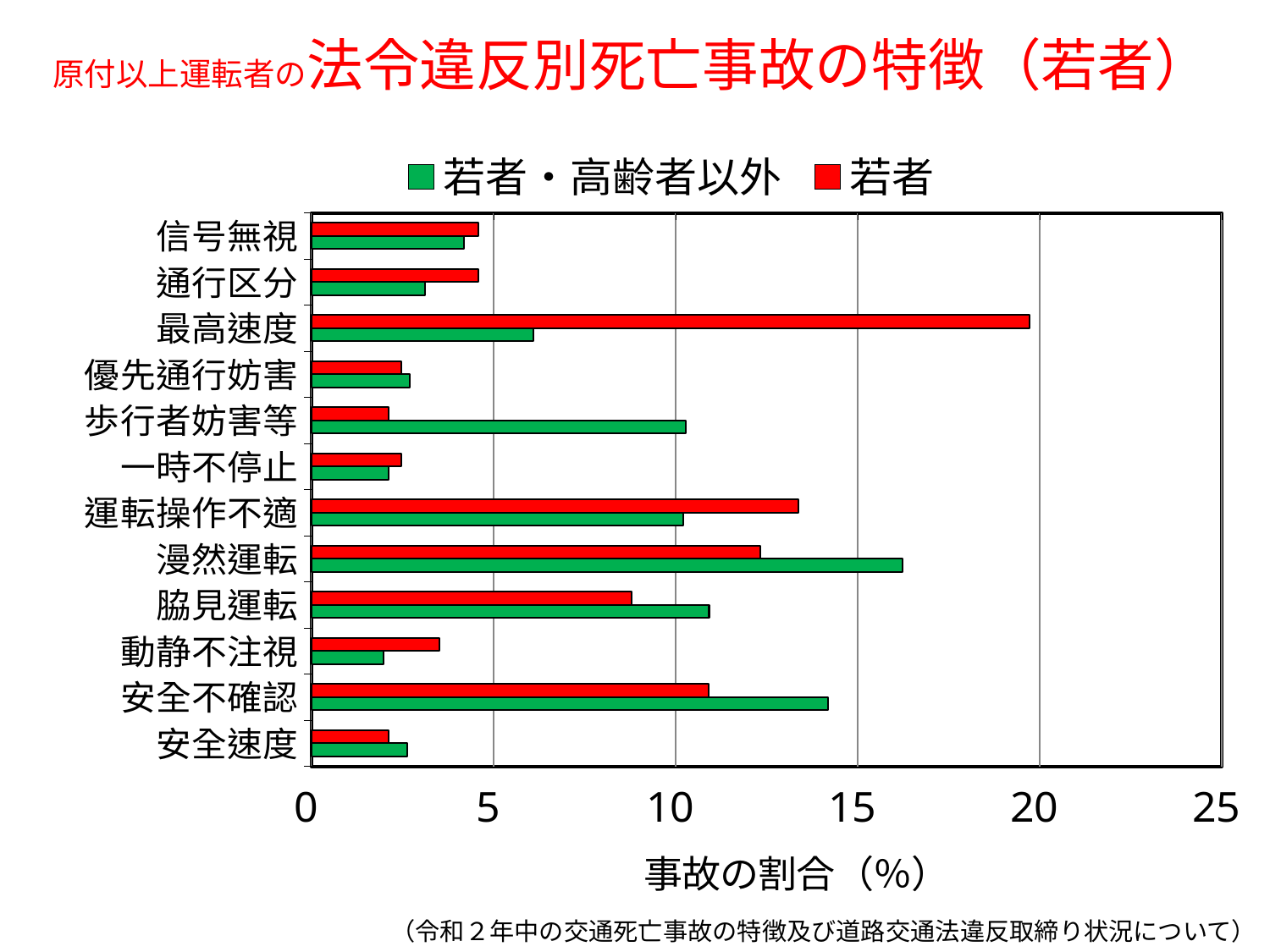
What kind of chart is shown on the slide? bar chart What is the label of the x axis? 事故の割合（%） Which category has the highest value for the 若者 series? 最高速度 Is the 若者 value for 脇見運転 greater or less than 10? less Is the 若者・高齢者以外 value for 漫然運転 greater or less than 15? greater Is the 若者 value for 運転操作不適 greater or less than 10? greater For 歩行者妨害等, which series has the larger value, 若者 or 若者・高齢者以外? 若者・高齢者以外 How many violation categories are shown on the y axis? 12 For 最高速度, which series has the larger value, 若者 or 若者・高齢者以外? 若者 Which category has the highest value for the 若者・高齢者以外 series? 漫然運転 How many series does the legend list? 2